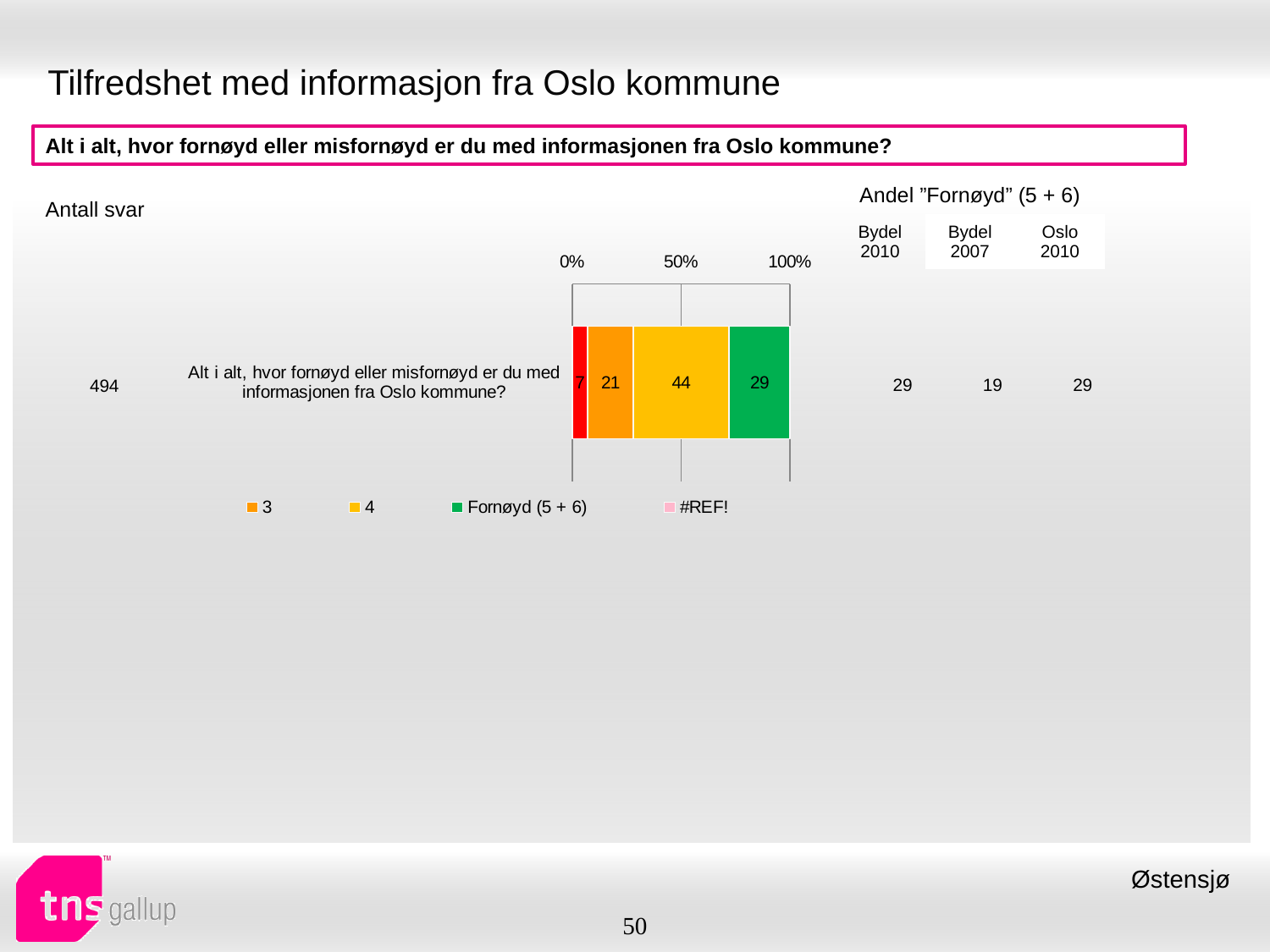
What is the value of the '3' segment in the stacked bar? 21 What type of chart is shown on the slide? bar chart Which legend series has the largest segment in the stacked bar? 4 What is the number of responses (Antall svar) shown for the question? 494 How many bars (categories) does the chart contain? 1 What is the value of the 'Fornøyd (5 + 6)' segment in the stacked bar? 29 How many entries does the chart legend list? 4 Which is larger in the stacked bar, the 'Fornøyd (5 + 6)' segment or the '3' segment? Fornøyd (5 + 6) What is the value of the '4' segment in the stacked bar? 44 In the 'Andel "Fornøyd" (5 + 6)' table, what is the value for Bydel 2007? 19 What is the difference between the '4' segment and the '3' segment in the stacked bar? 23 What colour is the 'Fornøyd (5 + 6)' segment in the stacked bar? green